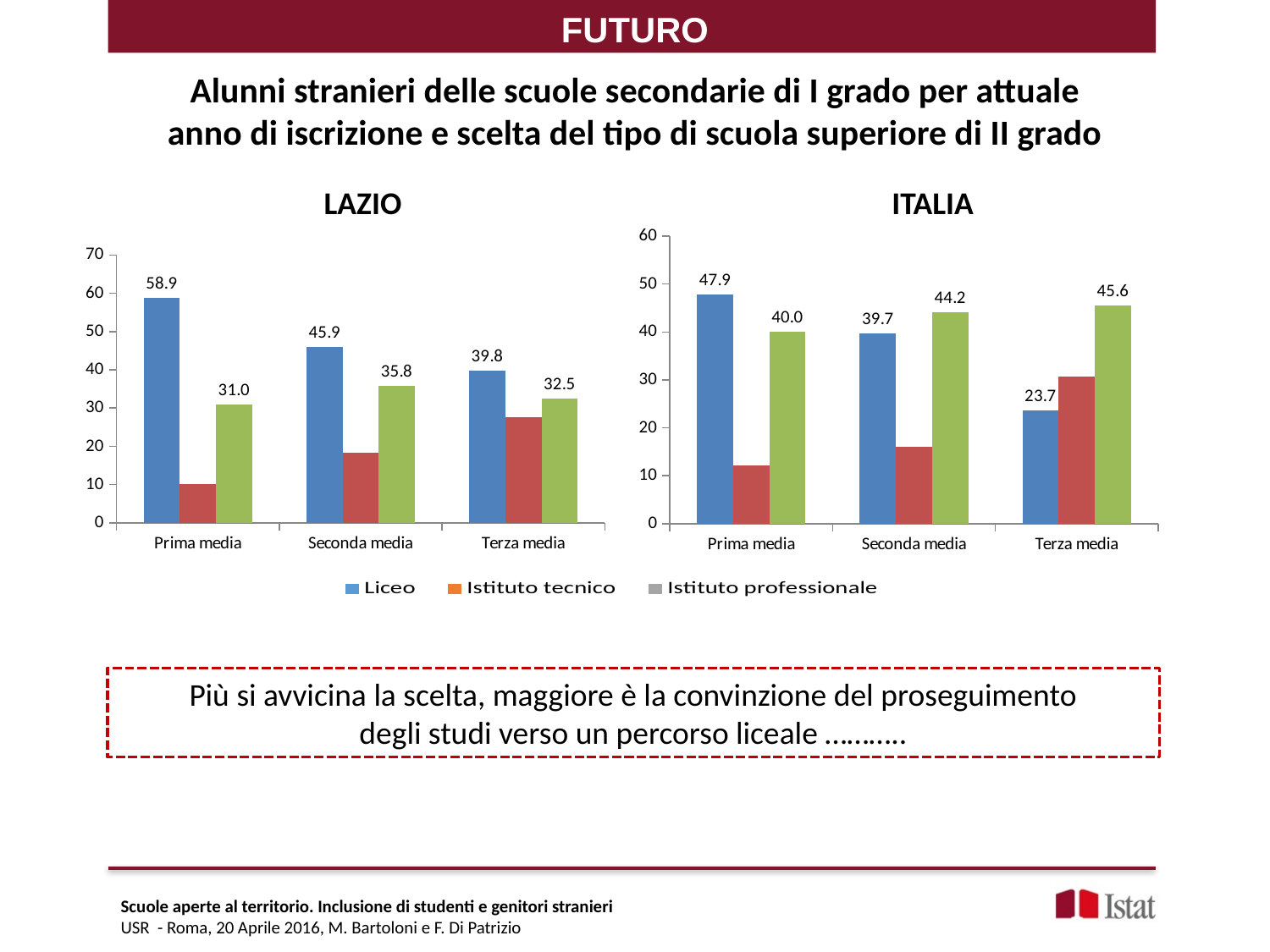
How many categories are shown on the x axis of the LAZIO chart? 3 In the ITALIA chart, is the value for Istituto tecnico in Terza media greater or less than 20? greater How many series does the legend list? 3 In the LAZIO chart, which category has the highest value for Liceo? Prima media In the ITALIA chart, what is the value for Istituto professionale in Terza media? 45.6 In the ITALIA chart, what is the difference between the Istituto professionale values for Terza media and Prima media? 5.6 In the LAZIO chart, what is the difference between the Liceo values for Prima media and Terza media? 19.1 In the ITALIA chart, for Seconda media, which is larger: Liceo or Istituto professionale? Istituto professionale In the LAZIO chart, what is the value for Liceo in Prima media? 58.9 In the LAZIO chart, do the Liceo values rise or fall from Prima media to Terza media? fall In the LAZIO chart, is the value for Istituto tecnico in Prima media greater or less than 20? less In the ITALIA chart, which category has the lowest value for Liceo? Terza media